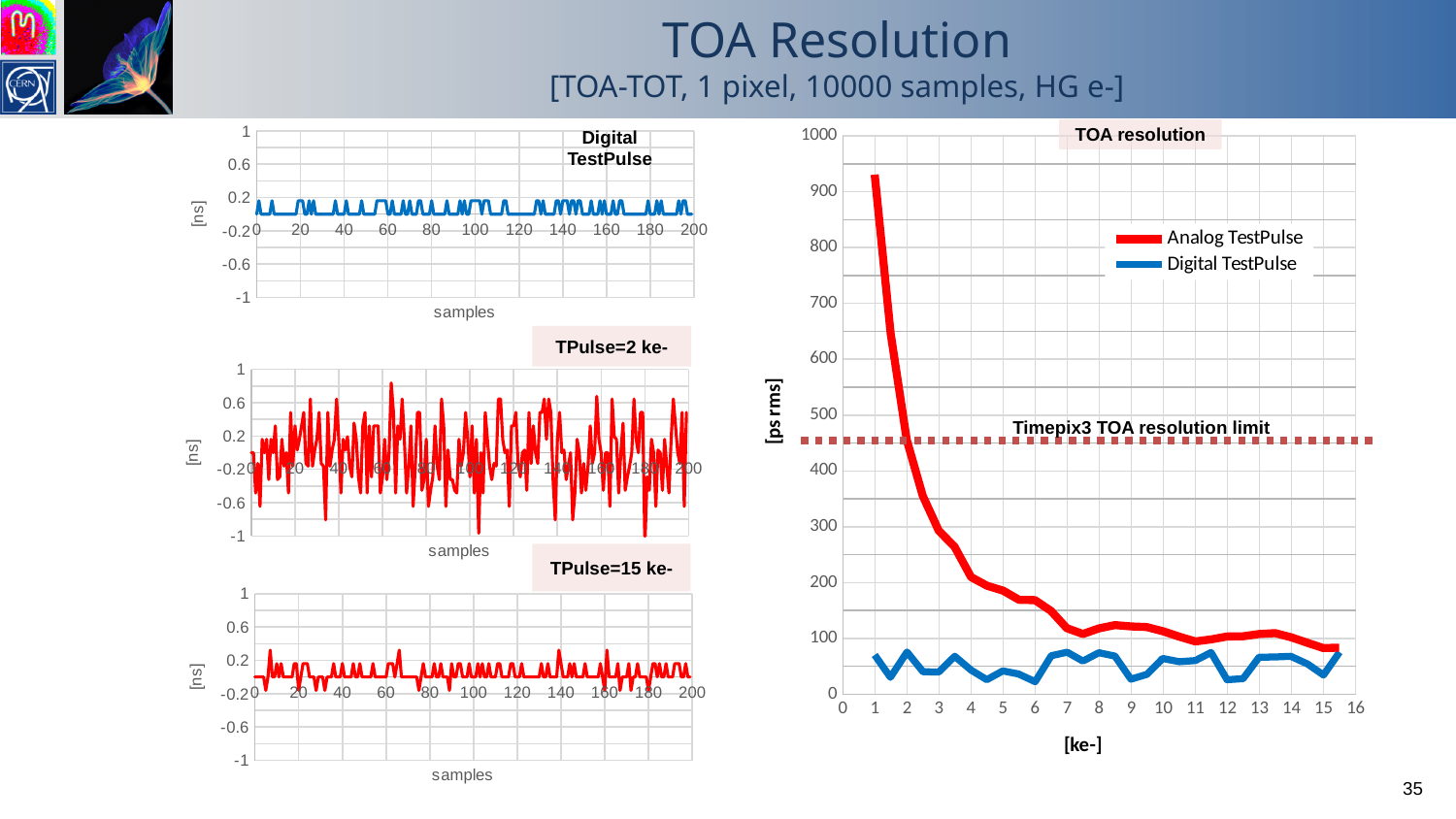
How many series does the legend of the TOA resolution chart list? 2 What are the two series named in the legend of the TOA resolution chart? Analog TestPulse and Digital TestPulse In the TOA resolution chart, do the Analog TestPulse values rise or fall as the charge in ke- increases? fall In the TOA resolution chart, which series has the larger value at 1 ke-, Analog TestPulse or Digital TestPulse? Analog TestPulse In the TOA resolution chart, is the Analog TestPulse value at 1 ke- greater or less than 800? greater What kind of chart is the TOA resolution chart on the right? line chart In the TOA resolution chart, is the Digital TestPulse value at 1 ke- greater or less than 100? less In the TOA resolution chart, which series has the larger value at 5 ke-, Analog TestPulse or Digital TestPulse? Analog TestPulse How many small sample charts are shown on the left side of the slide? 3 In the TOA resolution chart, is the Analog TestPulse value at 15 ke- greater or less than 200? less What label is written on the dashed horizontal line in the TOA resolution chart? Timepix3 TOA resolution limit